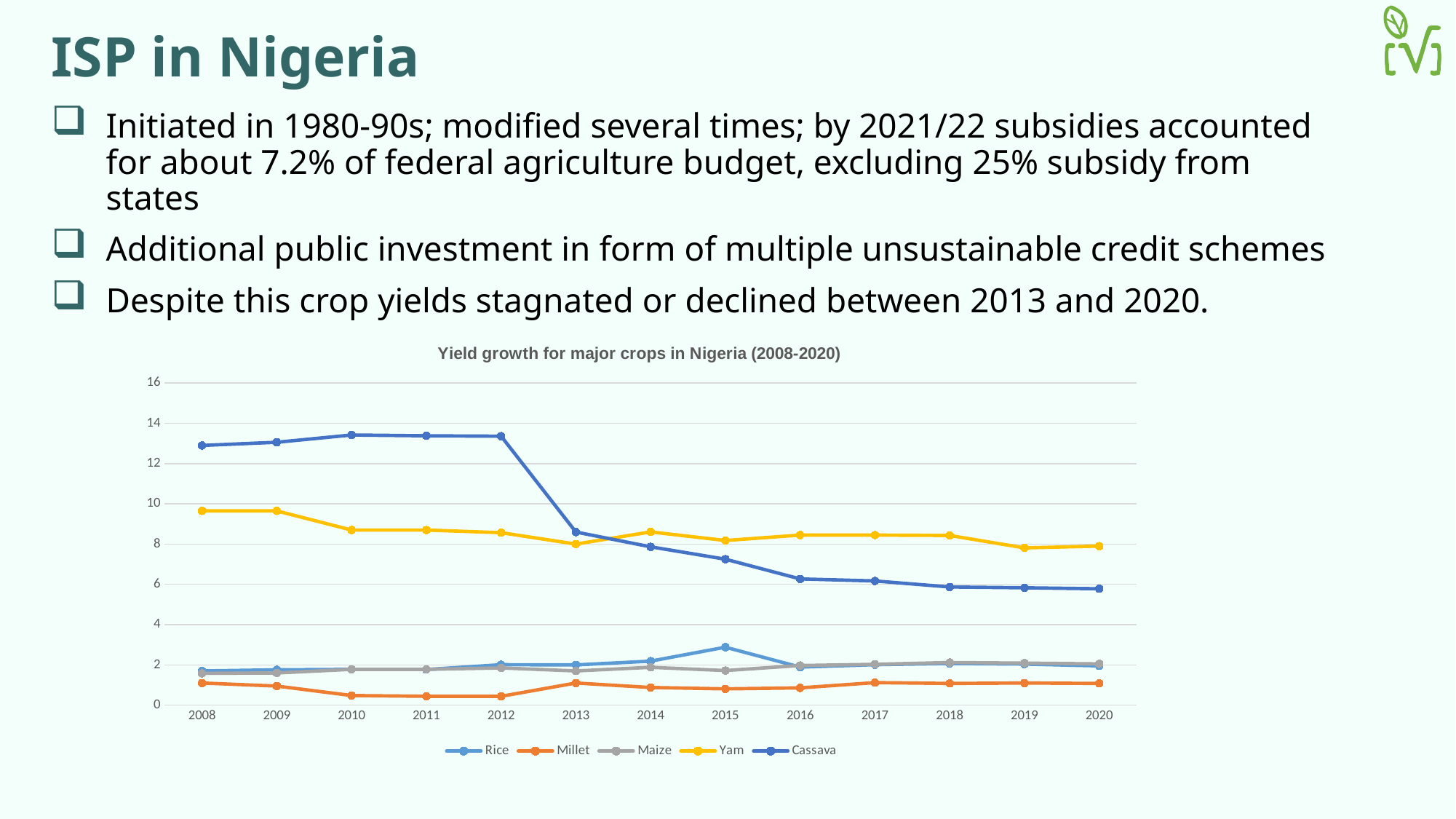
Does the Cassava line rise or fall between 2012 and 2013? fall Is the value for Cassava in 2008 greater or less than 12? greater Which is larger in 2020, the value for Yam or the value for Cassava? Yam What is the title of the chart? Yield growth for major crops in Nigeria (2008-2020) Which crop has the highest value in 2008? Cassava Is the value for Cassava in 2020 greater or less than 8? less What kind of chart is shown on the slide? line chart How many series does the chart legend list? 5 How many years are shown along the x axis of the chart? 13 Is the value for Yam in 2008 greater or less than 8? greater Which crop has the lowest value in 2012? Millet Which crop has the highest value in 2020? Yam